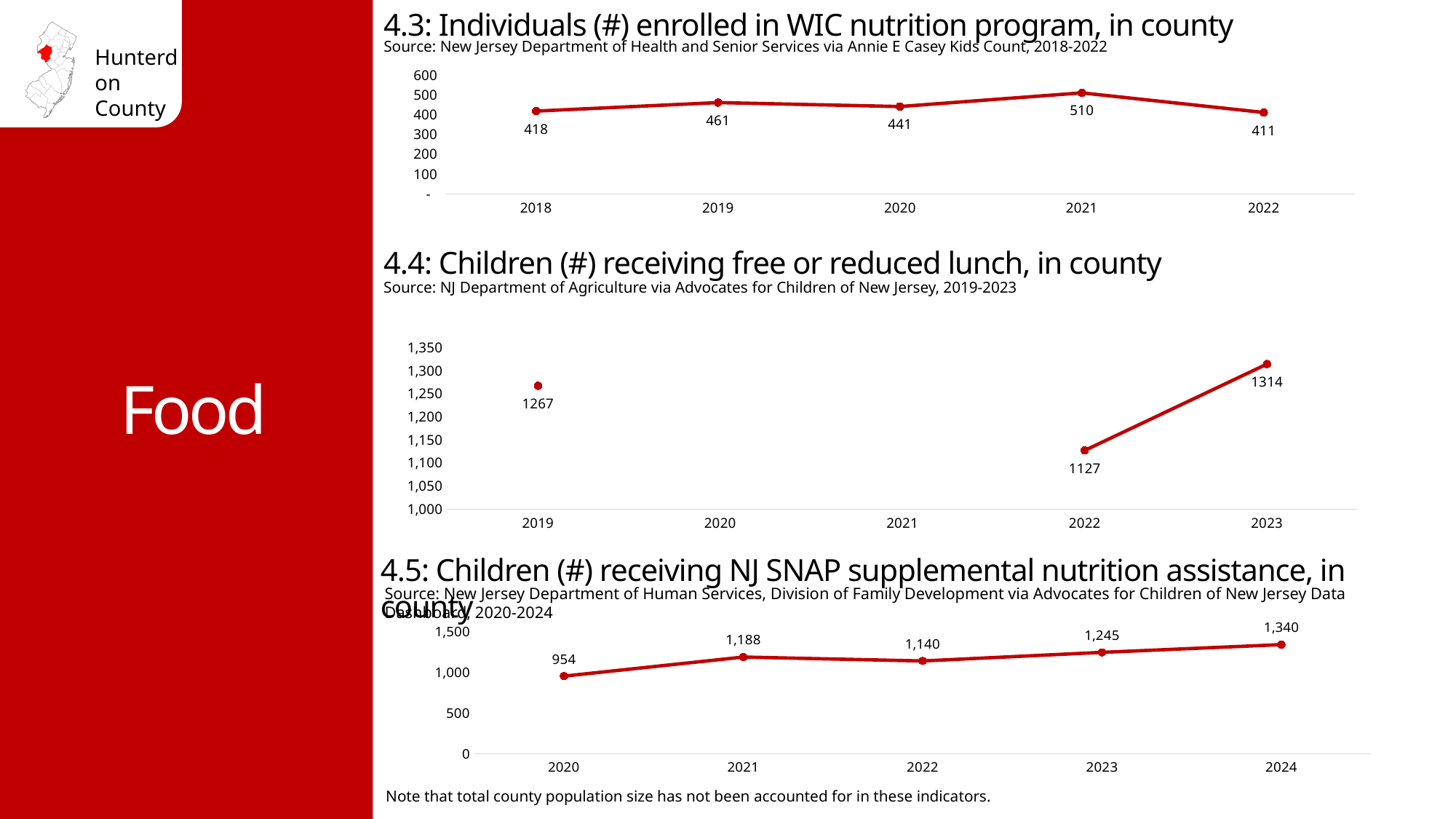
In the chart '4.4: Children (#) receiving free or reduced lunch, in county', is the value for 2019 larger or smaller than the value for 2022? larger In the chart '4.4: Children (#) receiving free or reduced lunch, in county', how many data points are plotted? 3 In the chart '4.3: Individuals (#) enrolled in WIC nutrition program, in county', how many years are plotted? 5 In the chart '4.4: Children (#) receiving free or reduced lunch, in county', what is the value for 2022? 1127 In the chart '4.3: Individuals (#) enrolled in WIC nutrition program, in county', what is the value for 2021? 510 In the chart '4.5: Children (#) receiving NJ SNAP supplemental nutrition assistance, in county', what is the value for 2020? 954 What kind of chart is '4.5: Children (#) receiving NJ SNAP supplemental nutrition assistance, in county'? line chart In the chart '4.3: Individuals (#) enrolled in WIC nutrition program, in county', what is the difference between the 2021 and 2018 values? 92 In the chart '4.5: Children (#) receiving NJ SNAP supplemental nutrition assistance, in county', what is the difference between the 2024 and 2023 values? 95 In the chart '4.5: Children (#) receiving NJ SNAP supplemental nutrition assistance, in county', which year has the highest value? 2024 In the chart '4.3: Individuals (#) enrolled in WIC nutrition program, in county', which year has the lowest value? 2022 In the chart '4.4: Children (#) receiving free or reduced lunch, in county', which year has the highest value? 2023